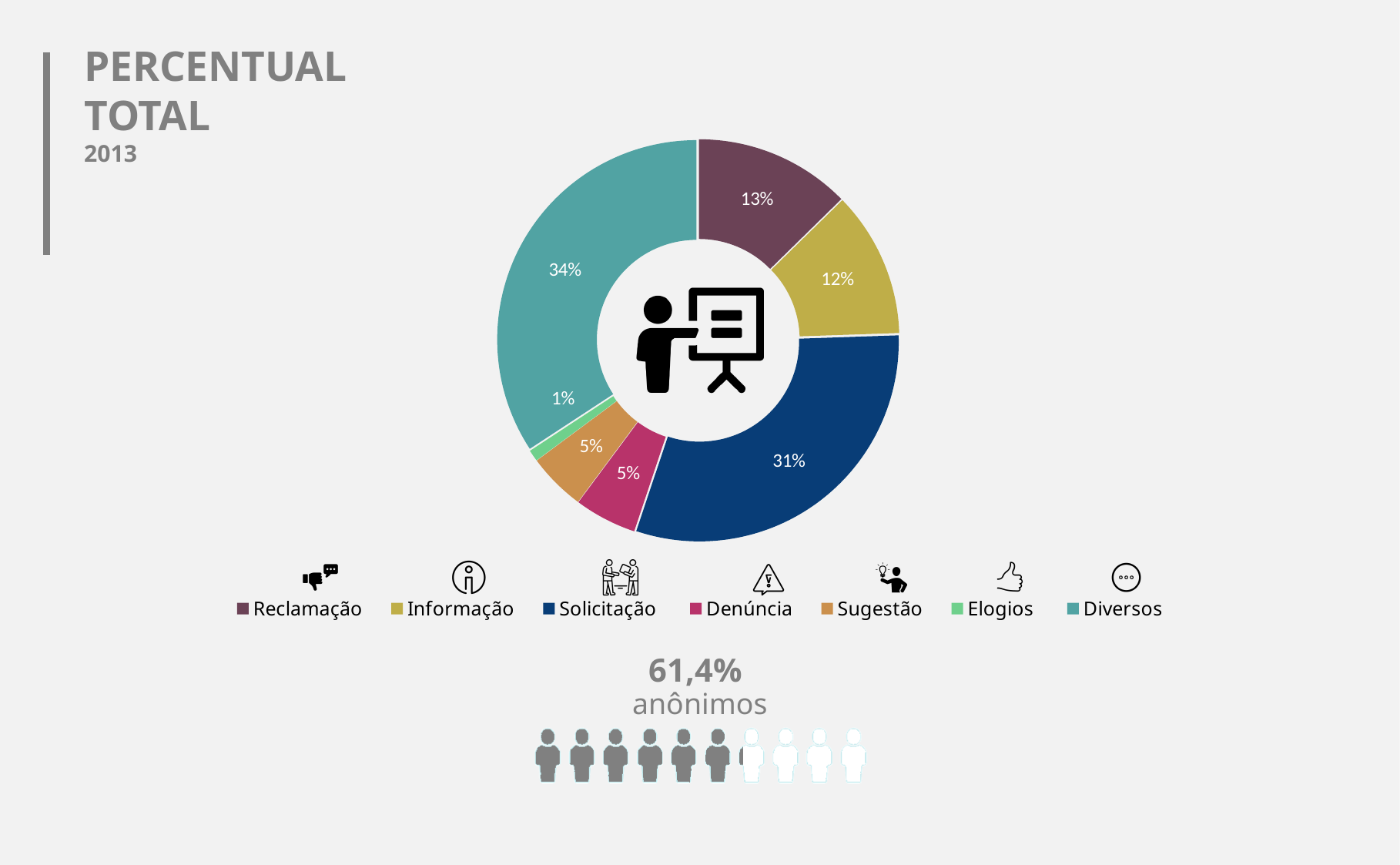
Which category has the largest share of the chart? Diversos What is the difference in percentage points between Diversos and Solicitação? 3 What percentage is shown for Elogios? 1% How many categories does the chart show? 7 What kind of chart is shown on the slide? Donut (pie) chart What percentage does Solicitação account for in the chart? 31% What percentage of the donut chart is Diversos? 34% What is the value shown for Reclamação? 13% Which is larger, Reclamação or Informação? Reclamação Which category has the smallest share of the chart? Elogios What year is shown under the chart title? 2013 What is the value shown for Informação? 12%